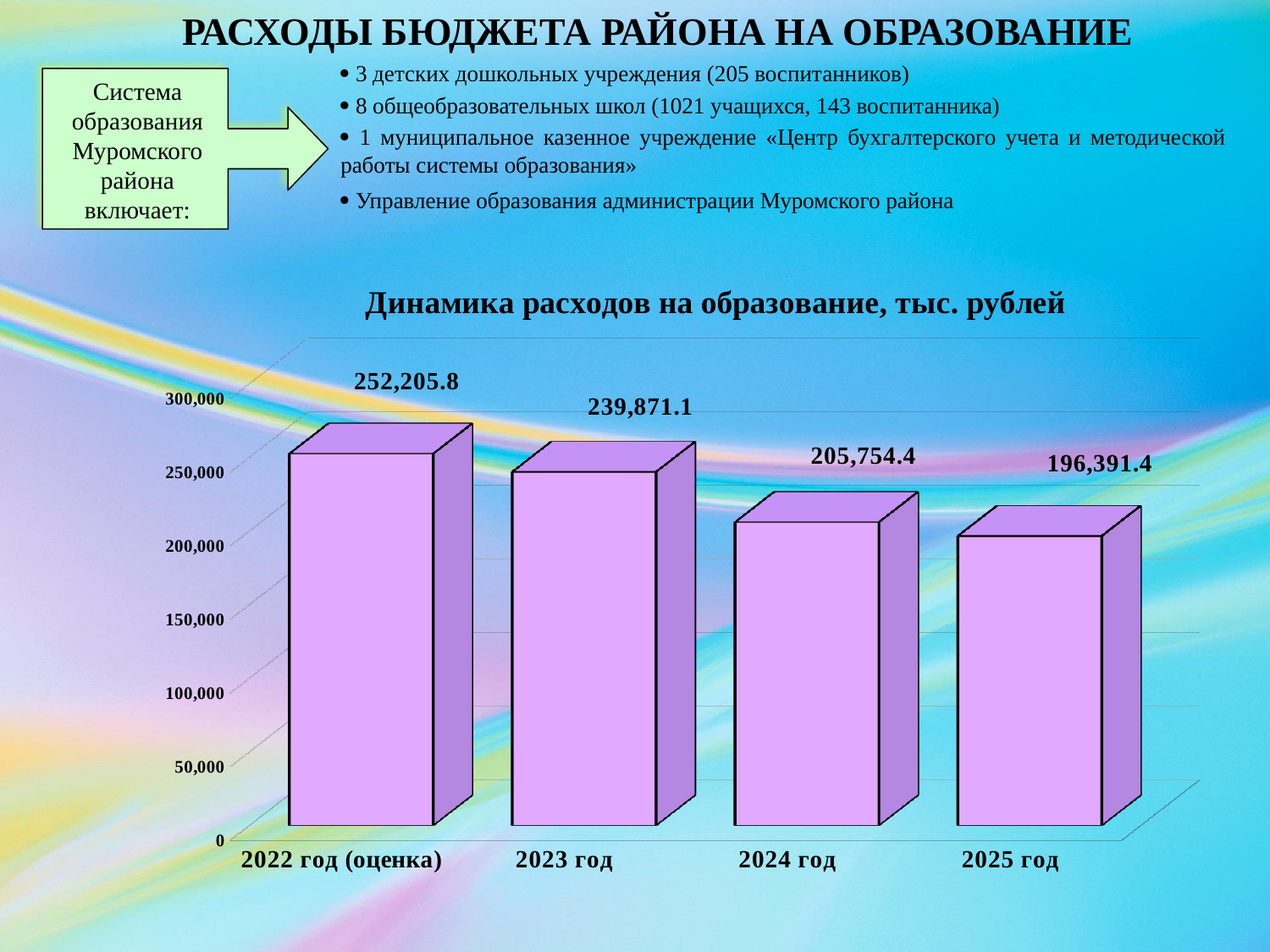
What is the difference between the values for 2022 год (оценка) and 2023 год? 12,334.7 Which year has the highest value? 2022 год (оценка) What is the value for 2023 год? 239,871.1 Which is larger, the value for 2023 год or the value for 2024 год? 2023 год Which year has the lowest value? 2025 год What is the value for 2025 год? 196,391.4 What kind of chart is shown on the slide? bar chart How many years are shown on the x axis? 4 Do the values rise or fall from 2022 год (оценка) to 2025 год? fall Is the value for 2024 год greater or less than 200,000? greater What is the difference between the values for 2024 год and 2025 год? 9,363.0 What is the value for 2022 год (оценка)? 252,205.8